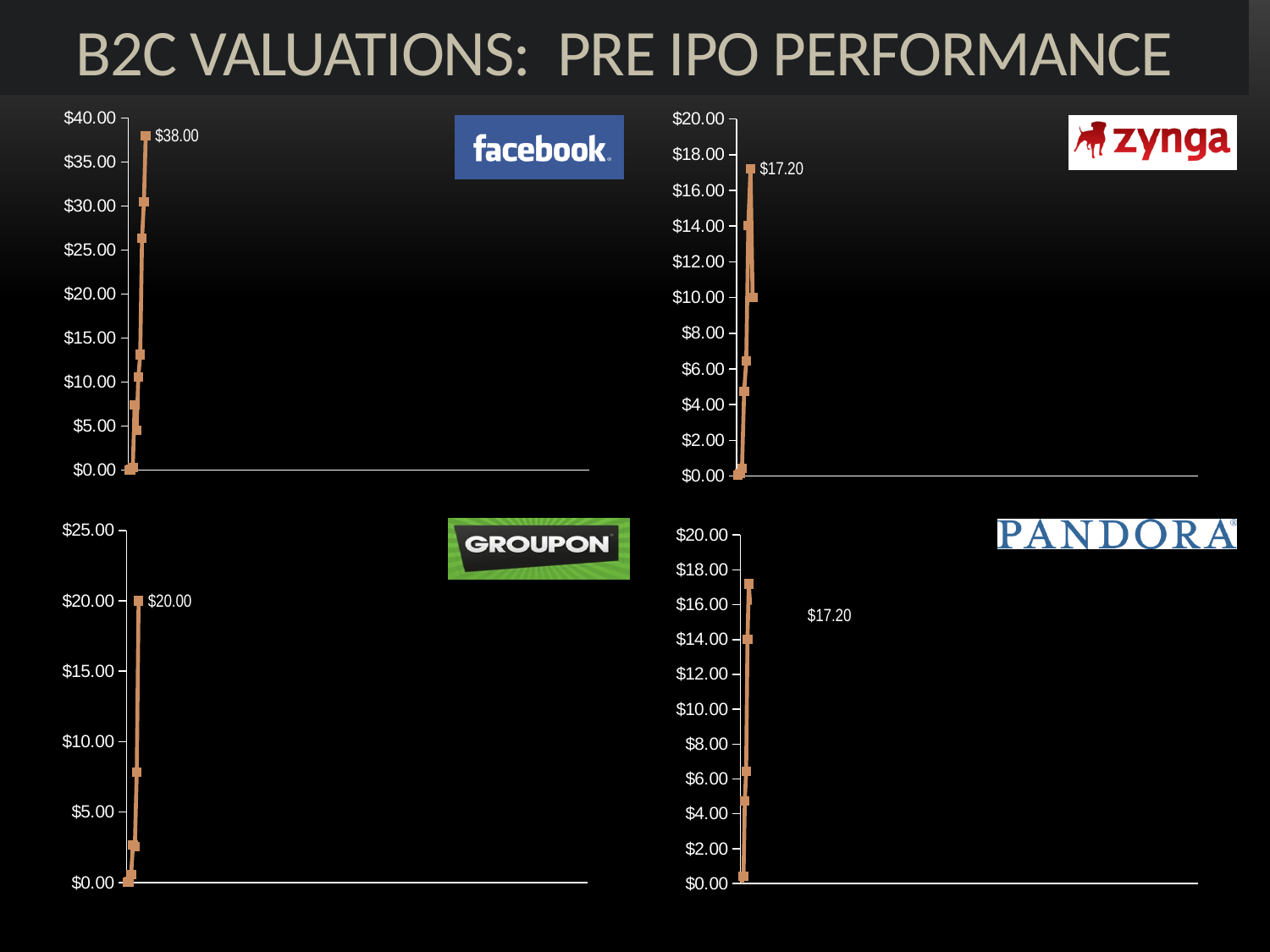
What is the difference between the labeled value on the Facebook chart and the labeled value on the Zynga chart? $20.80 On the Groupon chart, what value is printed as the data label? $20.00 Which is larger: the labeled value on the Facebook chart or the labeled value on the Groupon chart? Facebook On the Zynga chart, what value is printed as the data label? $17.20 What kind of chart is the Facebook chart? line chart On the Pandora chart, what value is printed as the data label? $17.20 What is the difference between the labeled value on the Groupon chart and the labeled value on the Pandora chart? $2.80 On the Zynga chart, is the value of the last point greater or less than $12.00? less On the Facebook chart, do the values generally rise or fall along the x axis? rise On the Groupon chart, do the values rise or fall along the x axis? rise What is the maximum value shown on the y axis of the Facebook chart? $40.00 On the Facebook chart, what is the value shown by the data label at the highest point? $38.00